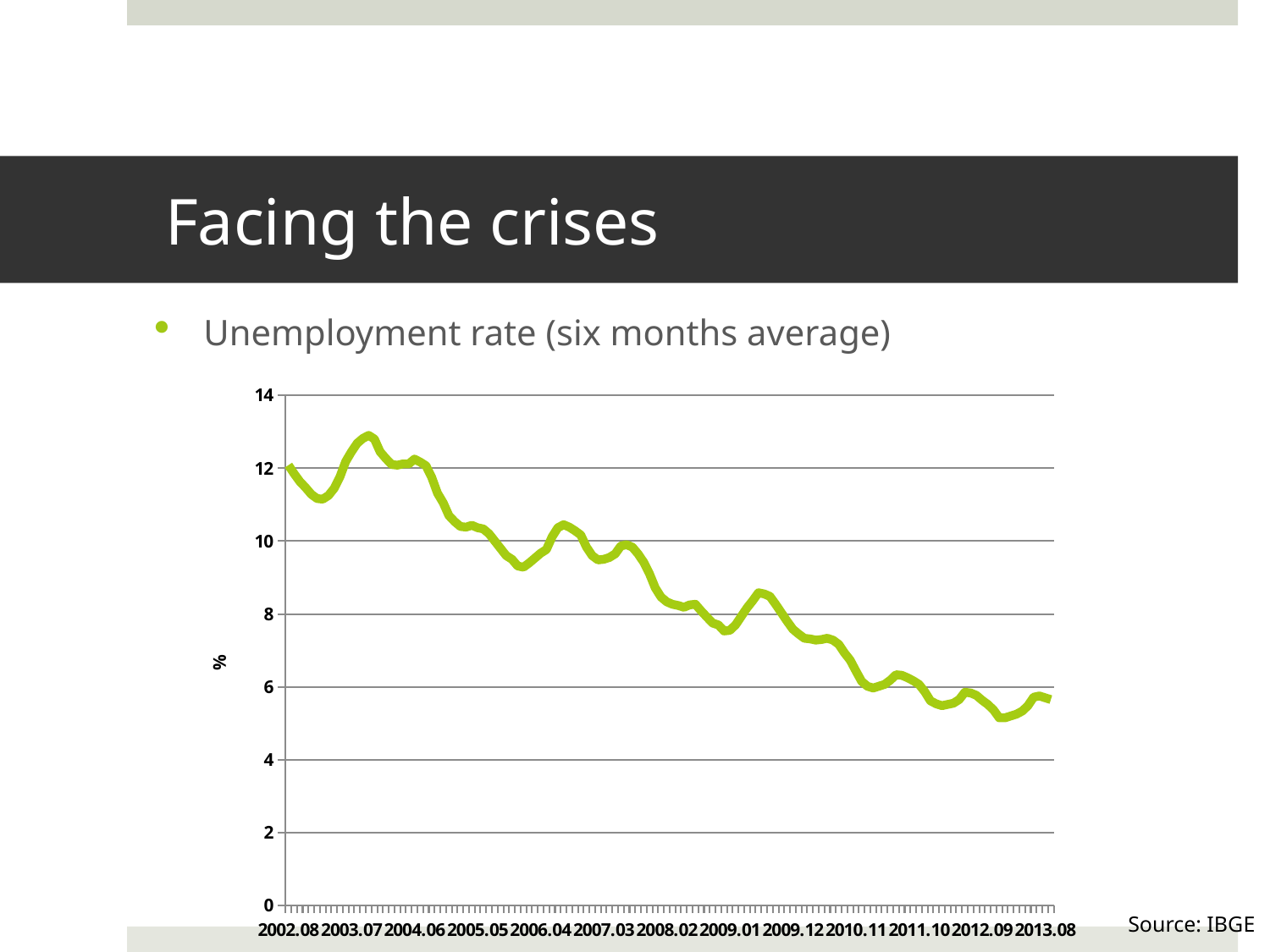
What is the source cited for the chart? IBGE Is the lowest point on the line greater or less than 6? less Is the unemployment rate at 2013.08 greater or less than 8? less Is the unemployment rate at 2011.10 greater or less than 8? less Which is larger, the unemployment rate at 2002.08 or at 2013.08? 2002.08 What kind of chart is shown on the slide? line chart What is the label on the vertical axis of the chart? % Overall, does the unemployment rate rise or fall from 2002.08 to 2013.08? fall